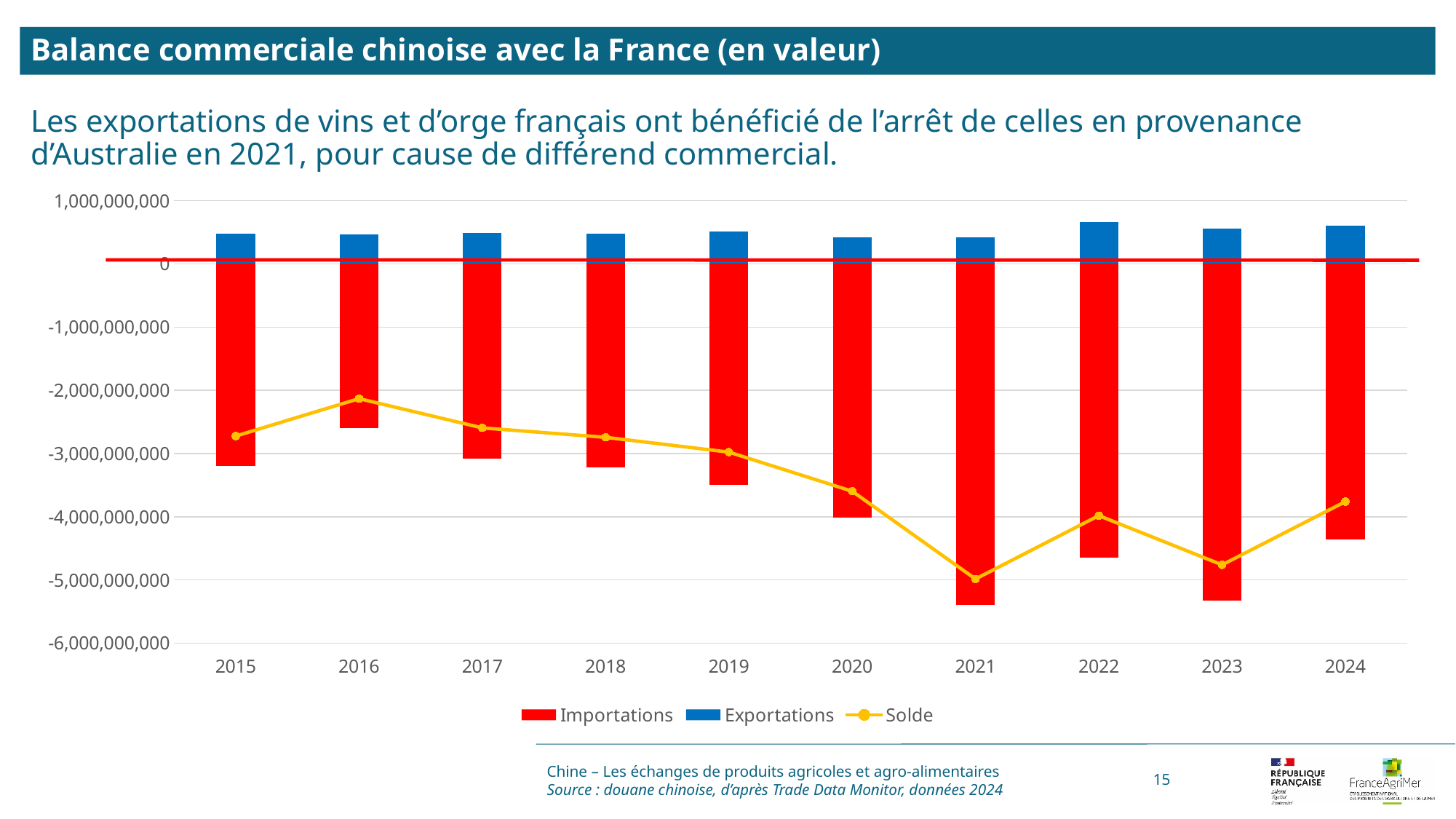
What are the three series listed in the chart legend? Importations, Exportations, Solde In which year is the Solde line at its lowest point? 2021 What kind of chart is shown on the slide? A combined bar and line chart Is the Solde value for 2016 greater or less than -3,000,000,000? greater How many series does the chart legend list? 3 Is the Solde value for 2021 greater or less than -4,000,000,000? less How many years are shown on the x axis of the chart? 10 In which year is the Solde line at its highest point? 2016 In which year is the Importations bar the shortest? 2016 Does the Solde line rise or fall from 2016 to 2021? fall What is the title of the slide containing the chart? Balance commerciale chinoise avec la France (en valeur) Is the Importations value for 2020 greater or less than -3,000,000,000? less